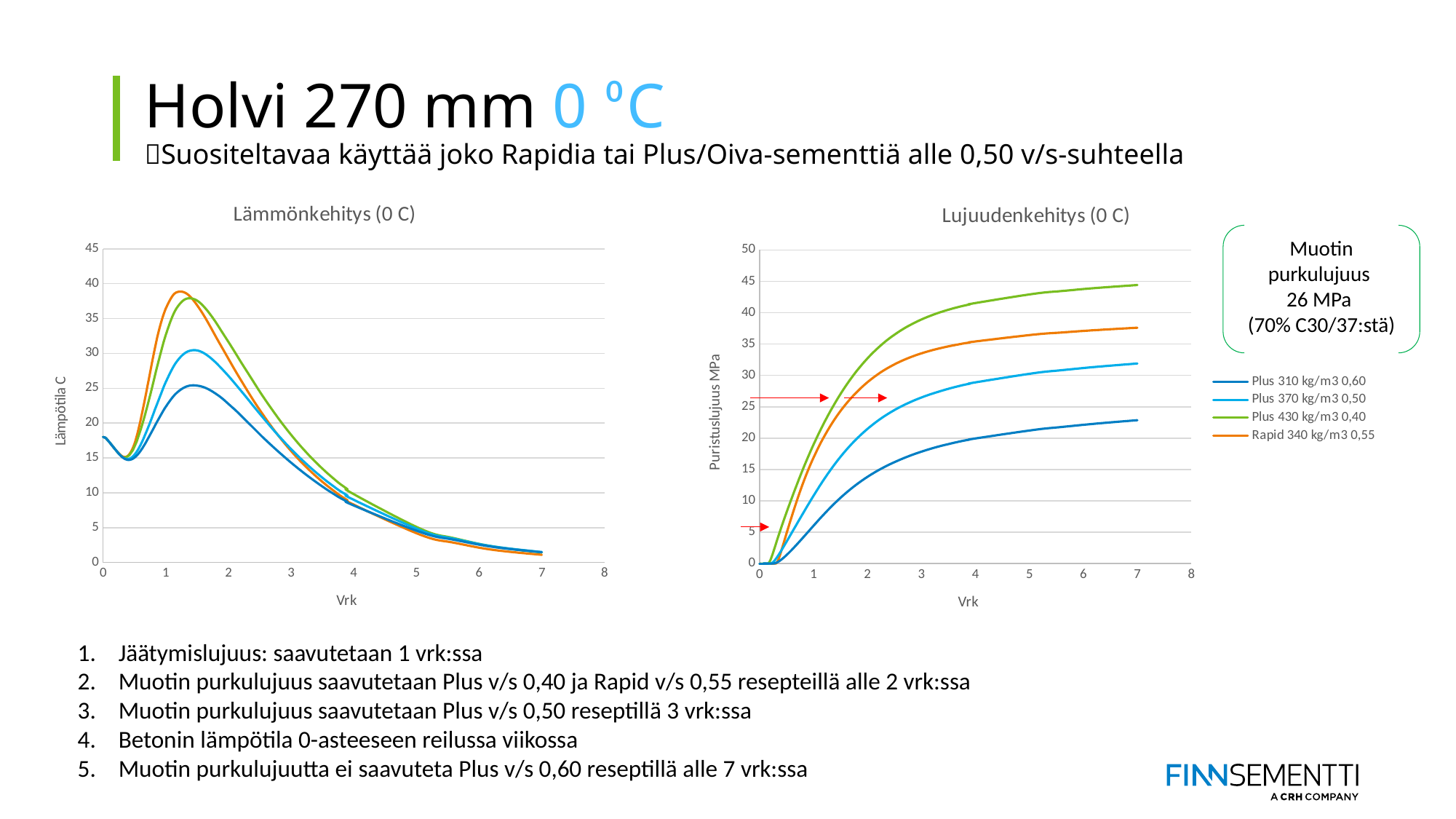
How many series does the legend list for the charts? 4 In the Lujuudenkehitys (0 C) chart, do the values rise or fall as Vrk increases? rise In the Lujuudenkehitys (0 C) chart, which series has the lowest value at 7 vrk? Plus 310 kg/m3 0,60 In the Lujuudenkehitys (0 C) chart, which series has the highest value at 7 vrk? Plus 430 kg/m3 0,40 In the Lämmönkehitys (0 C) chart, is the peak value of Plus 310 kg/m3 0,60 greater or less than 30? less In the Lujuudenkehitys (0 C) chart, is the value for Plus 430 kg/m3 0,40 at 7 vrk greater or less than 40? greater What kind of chart is the Lujuudenkehitys (0 C) chart? line chart In the Lujuudenkehitys (0 C) chart, is the value for Rapid 340 kg/m3 0,55 at 7 vrk greater or less than 35? greater What is the y-axis label of the Lujuudenkehitys (0 C) chart? Puristuslujuus MPa In the Lämmönkehitys (0 C) chart, which series reaches a higher peak temperature: Plus 370 kg/m3 0,50 or Plus 310 kg/m3 0,60? Plus 370 kg/m3 0,50 In the Lämmönkehitys (0 C) chart, do the values rise or fall between 2 and 7 vrk? fall